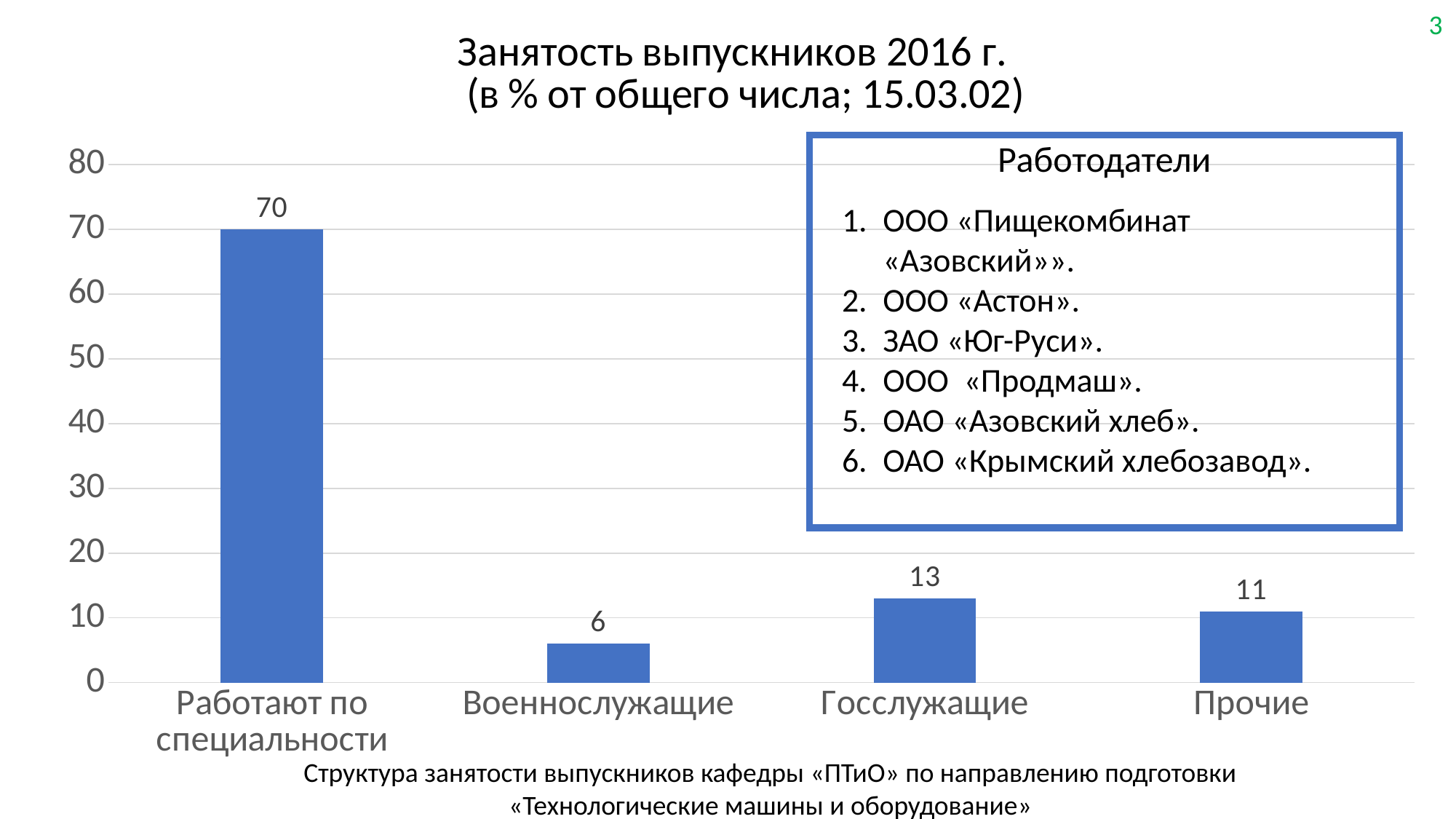
Which is larger, the value for «Госслужащие» or the value for «Военнослужащие»? Госслужащие Which category has the lowest value? Военнослужащие What is the value for «Военнослужащие»? 6 How many categories are shown on the x axis? 4 What is the value for «Госслужащие»? 13 What is the difference between the values for «Работают по специальности» and «Госслужащие»? 57 What is the value for «Работают по специальности»? 70 What is the value for «Прочие»? 11 What kind of chart is shown on the slide? Bar chart What is the title of the chart? Занятость выпускников 2016 г. (в % от общего числа; 15.03.02) What is the difference between the values for «Госслужащие» and «Прочие»? 2 Which category has the highest value? Работают по специальности